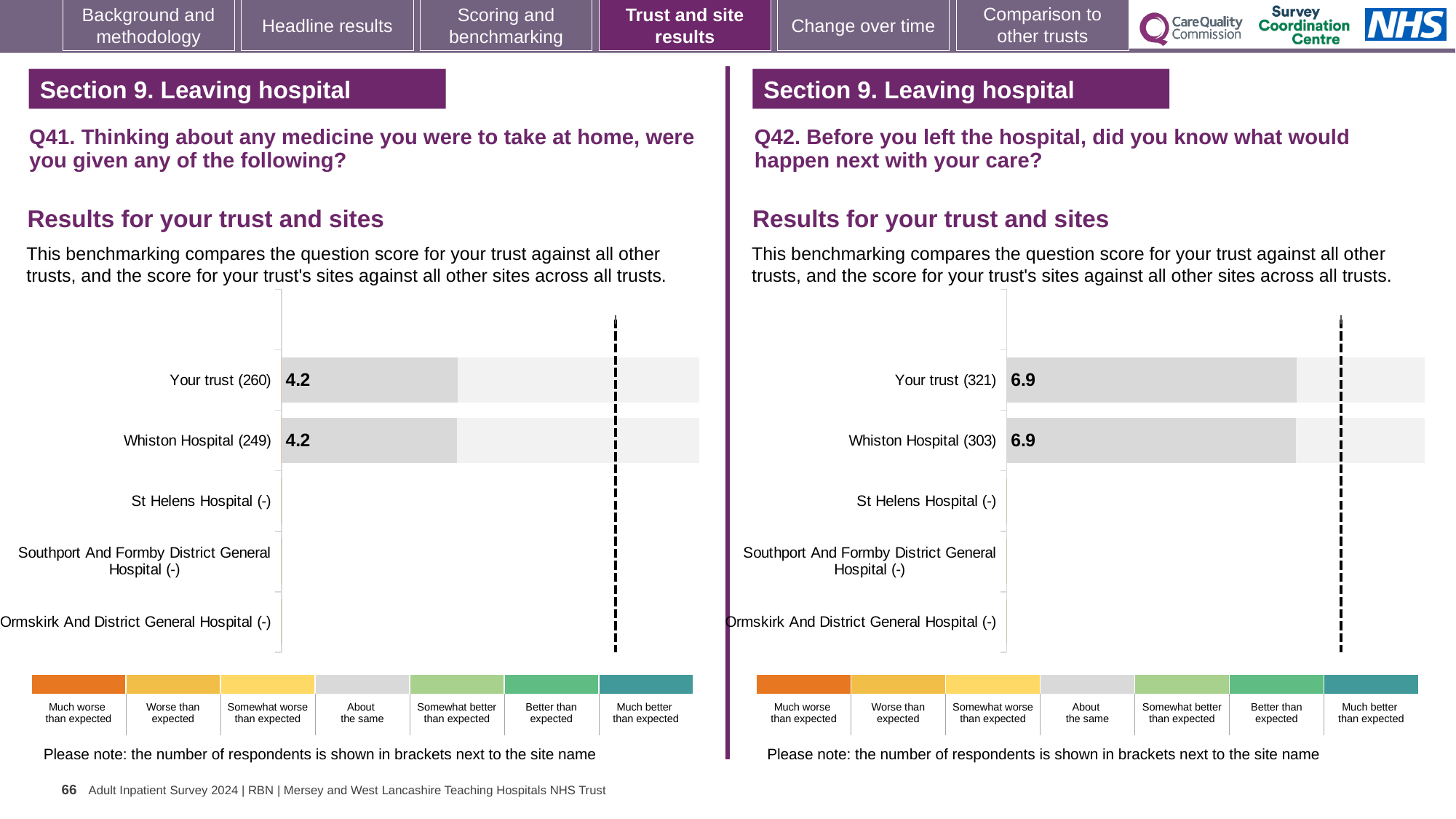
In the Q42 chart on the right, how many respondents are shown in brackets for Whiston Hospital? 303 In the Q42 chart on the right, what is the difference between the scores for Your trust and Whiston Hospital? 0 How many site or trust categories are listed on the Q42 chart on the right? 5 In the Q41 chart on the left, what is the score for Whiston Hospital? 4.2 In the Q41 chart on the left, which category is labelled with the most respondents in brackets? Your trust (260) How many site or trust categories are listed on the Q41 chart on the left? 5 What kind of chart is the Q42 chart on the right? Bar chart In the Q42 chart on the right, what is the score for Your trust? 6.9 In the Q42 chart on the right, what is the score for Whiston Hospital? 6.9 In the Q41 chart on the left, what is the score for Your trust? 4.2 In the Q41 chart on the left, how many respondents are shown in brackets for Your trust? 260 In the Q41 chart on the left, what is the difference between the scores for Your trust and Whiston Hospital? 0